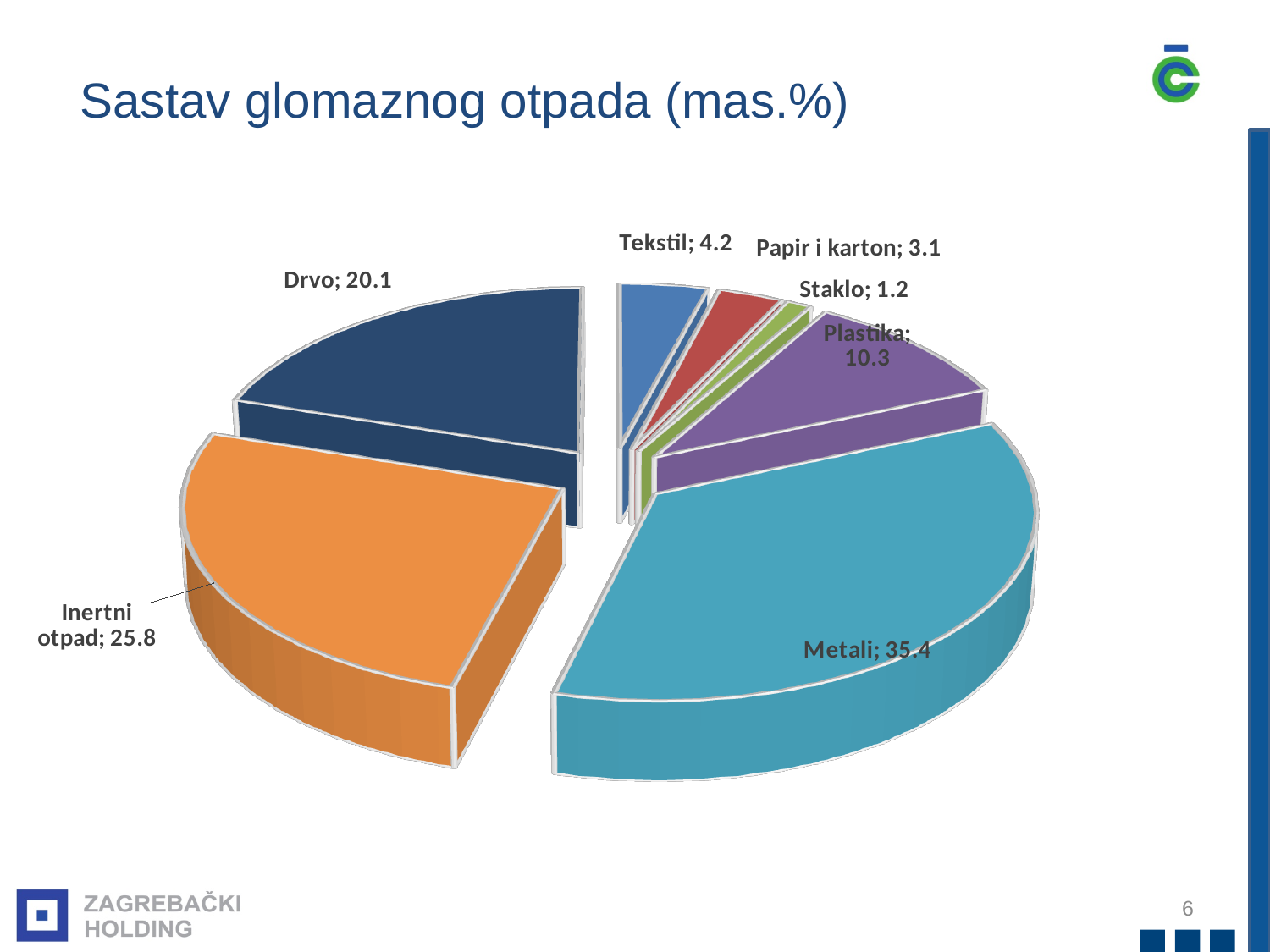
What is the value for Metali? 35.4 What is the value for Drvo? 20.1 What is the value for Staklo? 1.2 What is the value for Inertni otpad? 25.8 Which category has the smallest slice? Staklo What is the title of the slide? Sastav glomaznog otpada (mas.%) What is the value for Plastika? 10.3 Which category has the largest slice? Metali Which is larger, Tekstil or Papir i karton? Tekstil What type of chart is shown on the slide? Pie chart How many categories are shown in the pie chart? 7 What is the difference between the values for Metali and Inertni otpad? 9.6